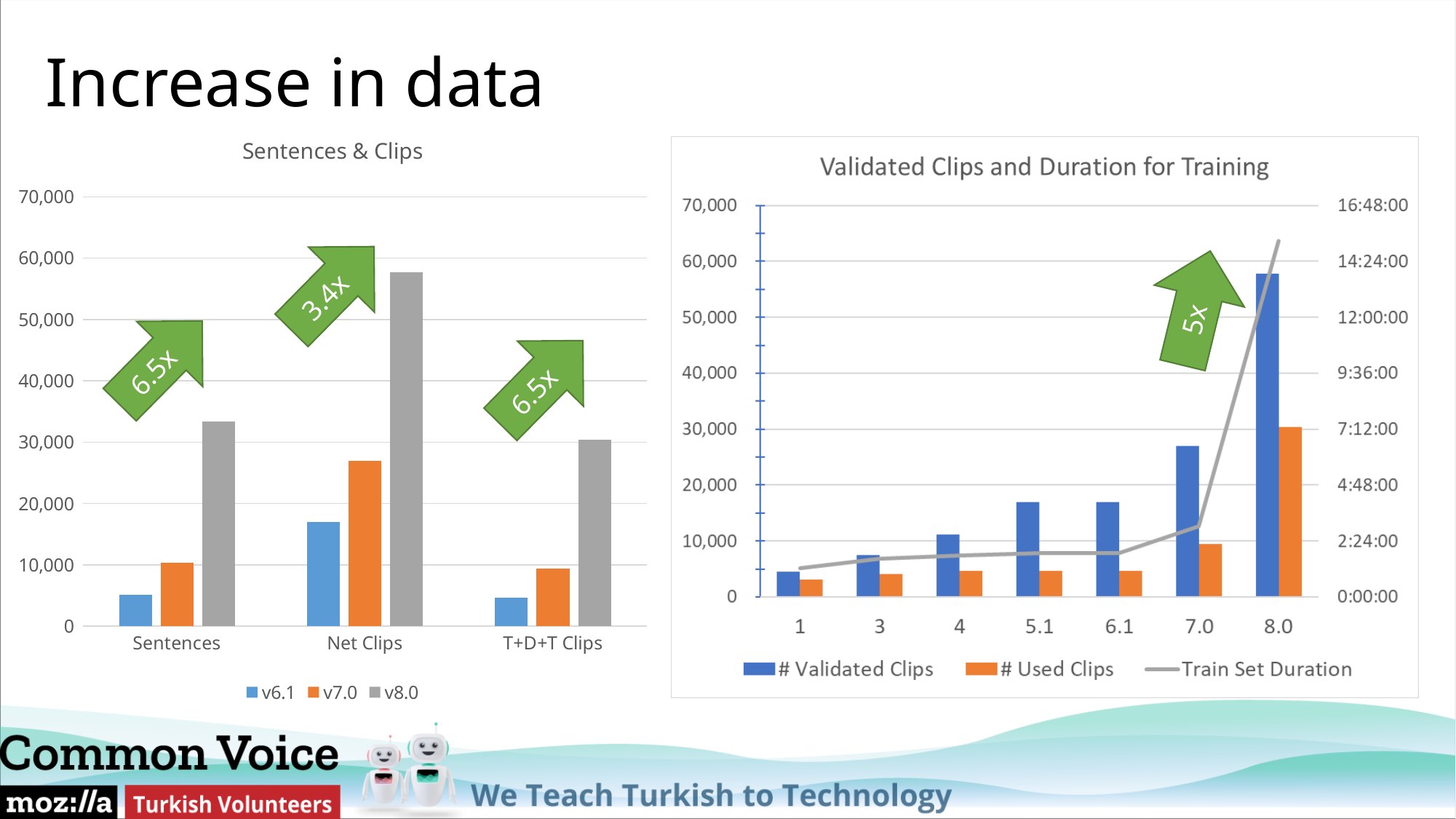
In the "Sentences & Clips" chart, is the v8.0 value for Sentences greater or less than 30,000? greater In the "Sentences & Clips" chart, which category has the highest v8.0 bar? Net Clips How many categories are shown on the x axis of the "Sentences & Clips" chart? 3 In the "Validated Clips and Duration for Training" chart, how many version categories are shown on the x axis? 7 What kind of chart is the "Sentences & Clips" chart on the left? bar chart In the "Sentences & Clips" chart, is the v6.1 value for Net Clips greater or less than 20,000? less In the "Validated Clips and Duration for Training" chart, is the # Validated Clips value at version 8.0 greater or less than 50,000? greater In the "Validated Clips and Duration for Training" chart, at which version is # Validated Clips highest? 8.0 In the "Validated Clips and Duration for Training" chart, how many series does the legend list? 3 In the "Validated Clips and Duration for Training" chart, does the Train Set Duration line rise or fall from version 1 to version 8.0? rise In the "Sentences & Clips" chart, which is larger: the v7.0 value for Net Clips or the v8.0 value for Sentences? v8.0 value for Sentences How many series does the legend of the "Sentences & Clips" chart list? 3